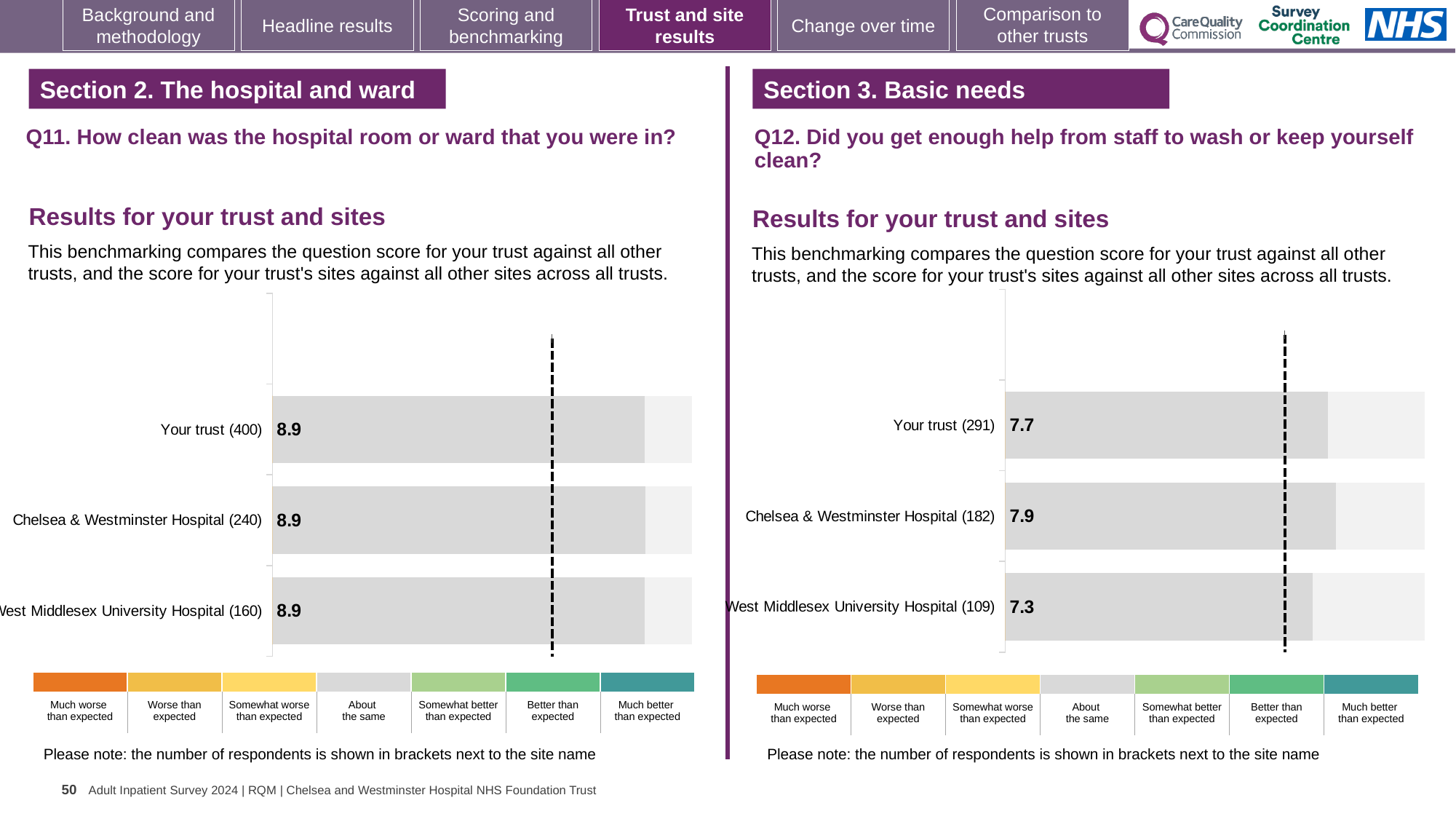
In the Q12 chart (right), which site or trust has the highest score? Chelsea & Westminster Hospital (182) How many bars are plotted in the Q11 chart (left)? 3 In the Q12 chart (right), what is the difference between the scores for Chelsea & Westminster Hospital (182) and West Middlesex University Hospital (109)? 0.6 In the Q11 chart (left), what is the score for Your trust (400)? 8.9 In the Q12 chart (right), which site or trust has the lowest score? West Middlesex University Hospital (109) In the Q12 chart (right), what is the score for Your trust (291)? 7.7 In the Q12 chart (right), what is the score for Chelsea & Westminster Hospital (182)? 7.9 In the Q12 chart (right), which has the larger score: Your trust (291) or West Middlesex University Hospital (109)? Your trust (291) In the Q12 chart (right), what is the score for West Middlesex University Hospital (109)? 7.3 How many respondents are shown in brackets for Chelsea & Westminster Hospital in the Q11 chart (left)? 240 In the Q11 chart (left), what is the score for West Middlesex University Hospital (160)? 8.9 What type of chart is used for the Q12 results (right)? Bar chart